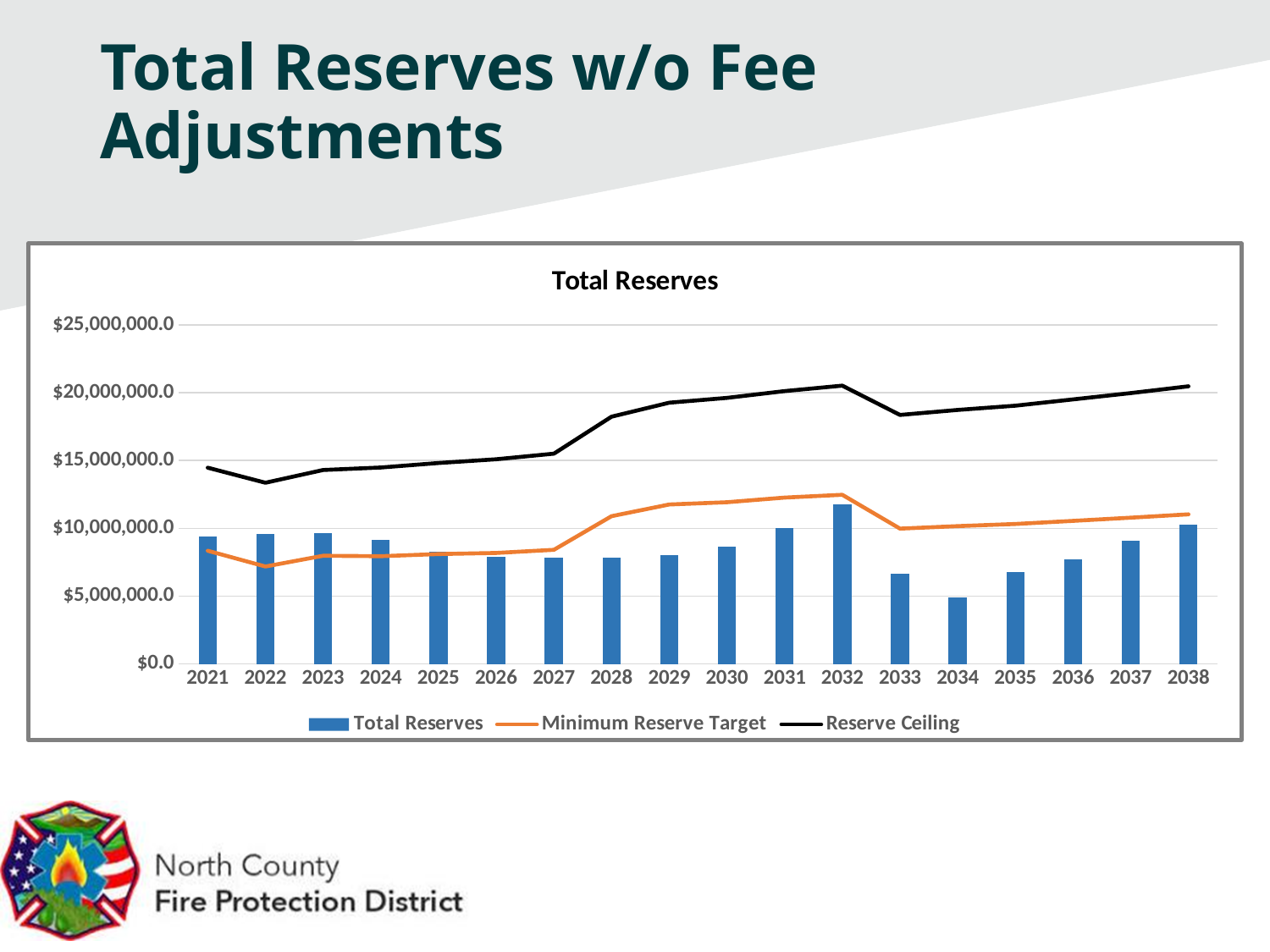
Which year has the lowest Total Reserves bar? 2034 Is the Reserve Ceiling value for 2022 greater or less than $15,000,000.0? less Does the Reserve Ceiling line rise or fall from 2033 to 2038? rise Which year has the highest Total Reserves bar? 2032 How many series does the chart legend list? 3 How many years are shown on the x axis of the chart? 18 Which year has the larger Total Reserves bar, 2031 or 2033? 2031 What is the title of the chart? Total Reserves Is the Reserve Ceiling value for 2032 greater or less than $20,000,000.0? greater Which series in the chart is drawn as bars rather than a line? Total Reserves Is the Total Reserves value for 2032 greater or less than $10,000,000.0? greater